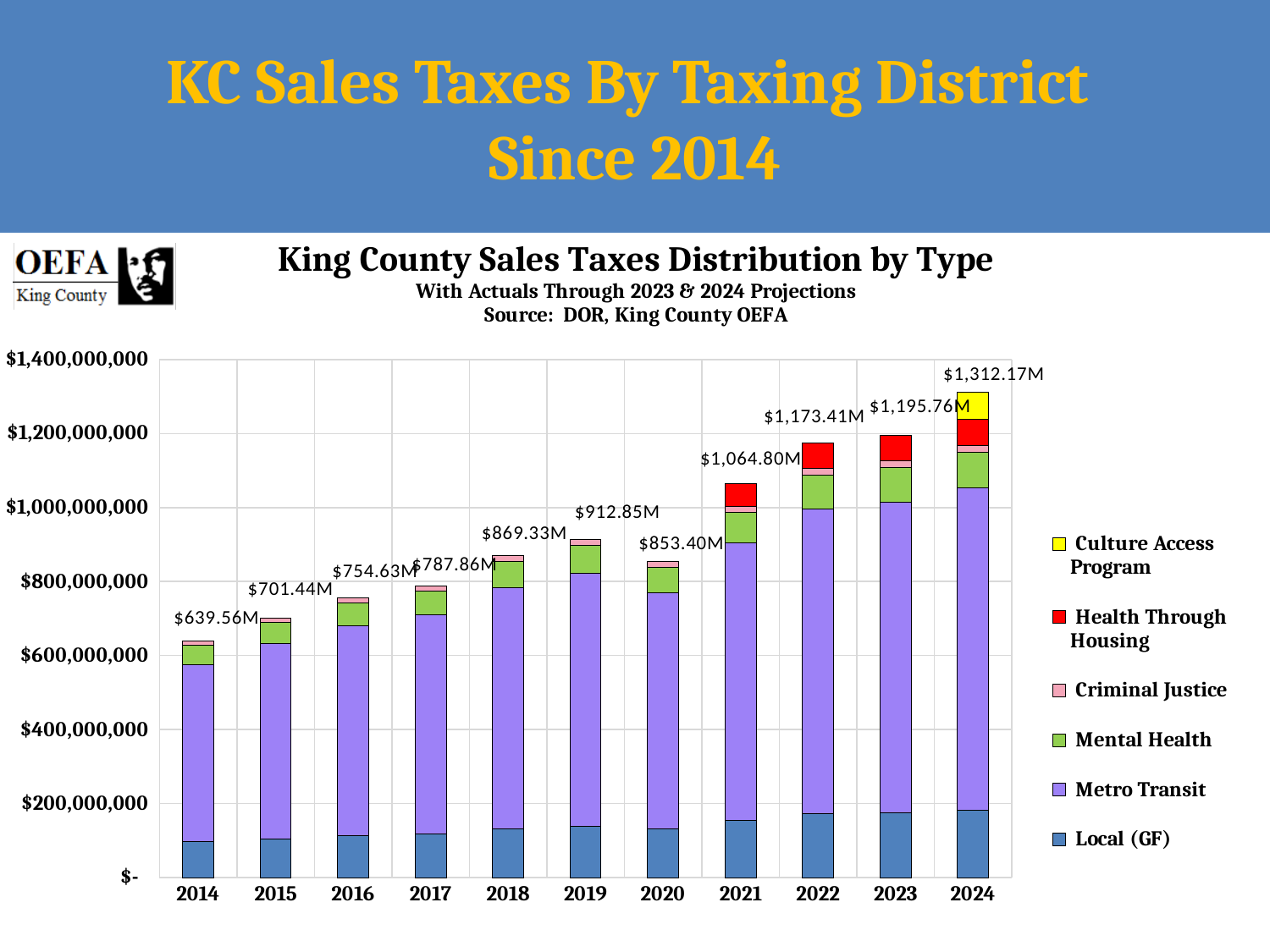
Is the Local (GF) value for 2014 greater or less than $200,000,000? less Which total is larger, 2019 or 2020? 2019 Which year has the lowest total? 2014 How many years are shown on the x axis? 11 What kind of chart is this? Stacked bar chart What is the total labeled for 2020? $853.40M Which year has the highest total? 2024 What is the total labeled for 2024? $1,312.17M How many series does the legend list? 6 What is the total labeled for 2014? $639.56M What is the difference between the 2024 total and the 2023 total? $116.41M What is the difference between the 2019 total and the 2020 total? $59.45M